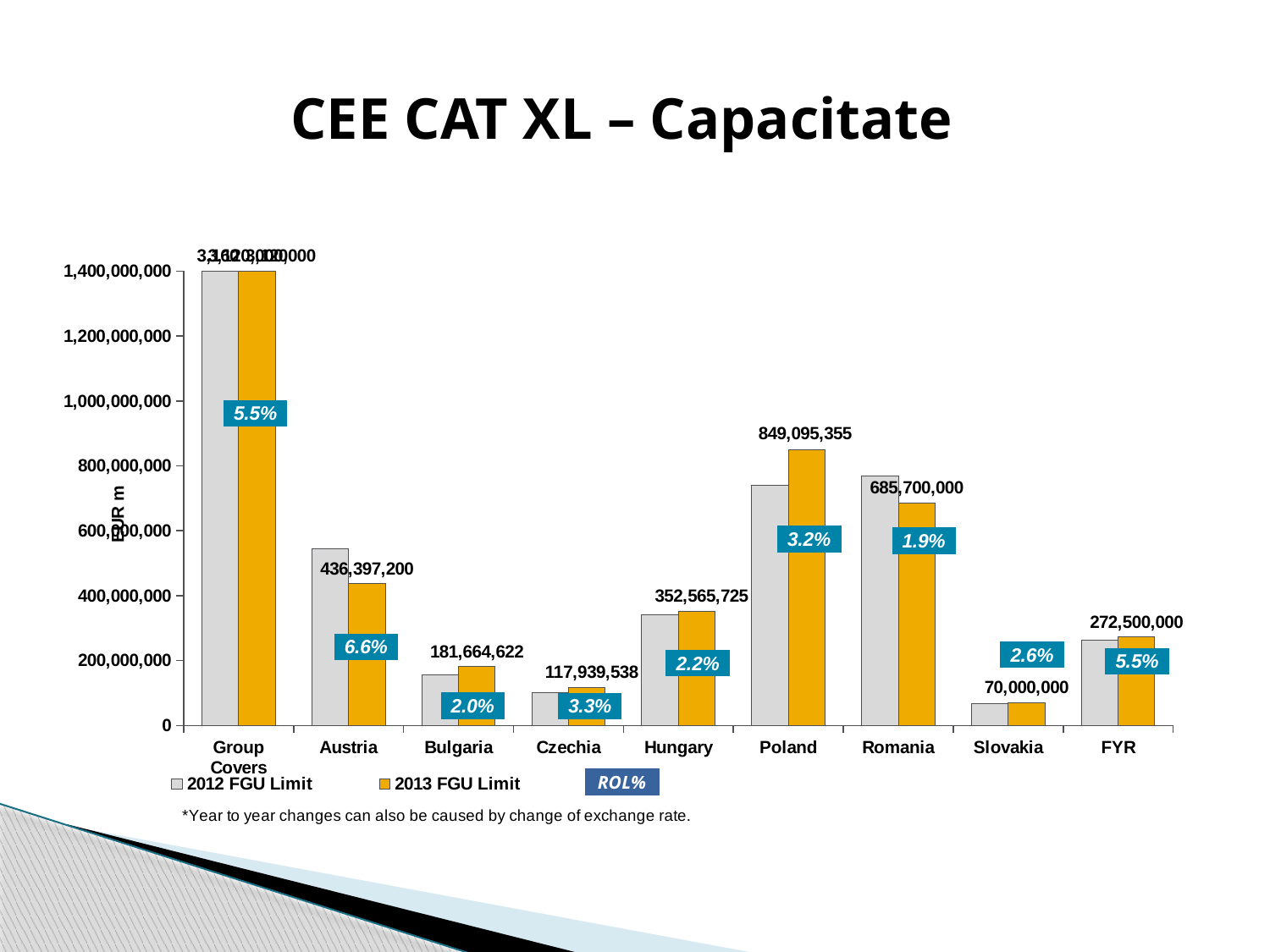
What is the 2013 FGU Limit for Poland? 849,095,355 Which category has the lowest 2013 FGU Limit? Slovakia What is the difference between the 2013 FGU Limit for FYR and for Slovakia? 202,500,000 What is the 2013 FGU Limit for Romania? 685,700,000 How many categories are shown on the x axis? 9 What is the 2013 FGU Limit for Slovakia? 70,000,000 Which has the larger 2013 FGU Limit, Austria or Hungary? Austria What ROL% is shown for Austria? 6.6% For Romania, which is larger, the 2012 FGU Limit or the 2013 FGU Limit? 2012 FGU Limit Which category has the highest 2013 FGU Limit? Group Covers Is the 2012 FGU Limit for Hungary greater or less than 400,000,000? less What is the difference between the 2013 FGU Limit for Poland and for Romania? 163,395,355